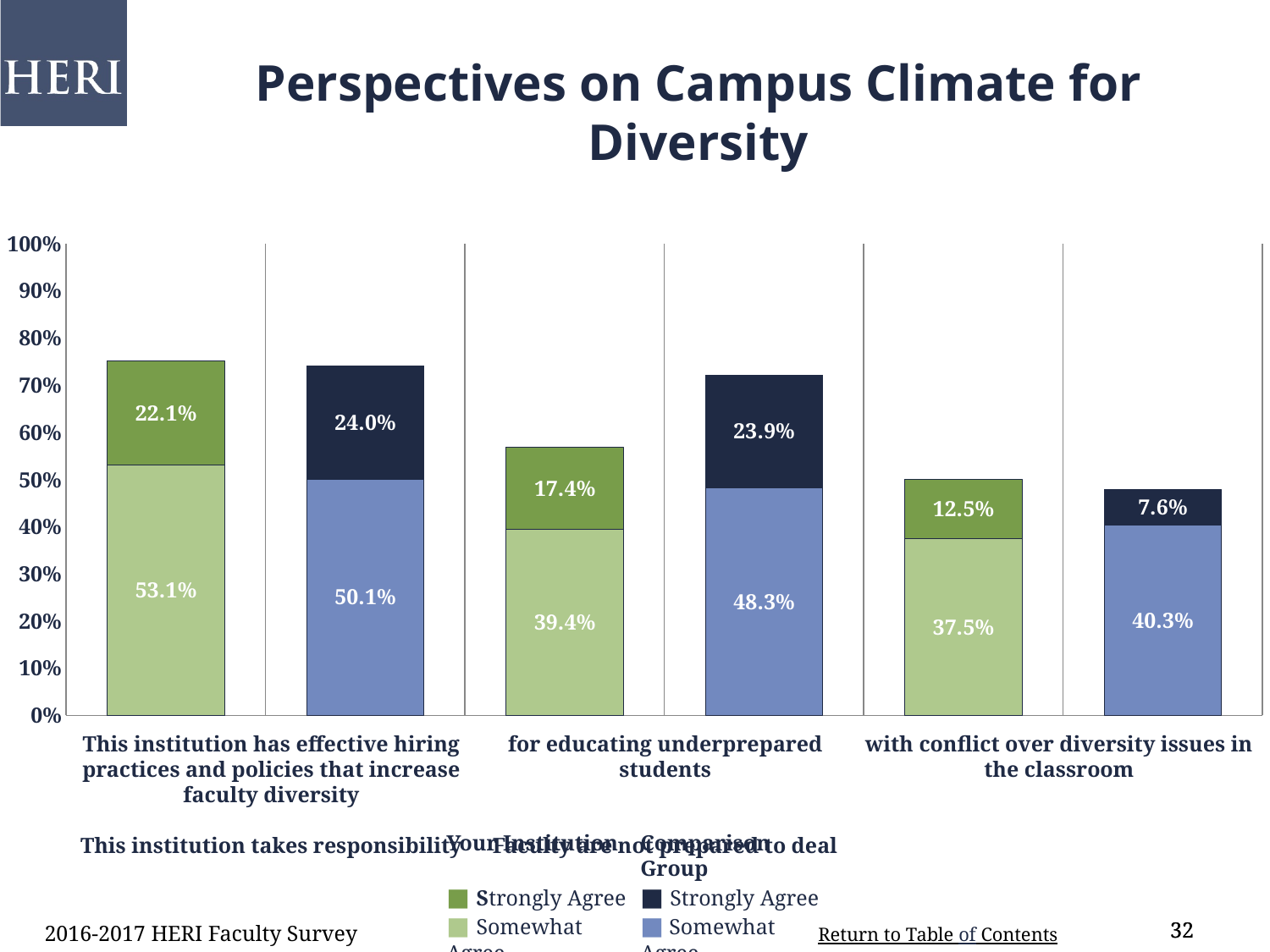
What percentage of the Comparison Group strongly agree that this institution has effective hiring practices and policies that increase faculty diversity? 24.0% What is the total percentage agreeing (strongly plus somewhat) for the Comparison Group on the statement about educating underprepared students? 72.2% What is the total percentage agreeing (strongly plus somewhat) for Your Institution on the statement about effective hiring practices that increase faculty diversity? 75.2% What percentage of the Comparison Group somewhat agree with the statement about educating underprepared students? 48.3% How many entries does the chart legend list? 4 What percentage of Your Institution faculty somewhat agree that this institution has effective hiring practices and policies that increase faculty diversity? 53.1% For the statement about educating underprepared students, which group has the larger 'Somewhat Agree' percentage, Your Institution or the Comparison Group? Comparison Group Which 'Strongly Agree' segment is the smallest on the chart? Comparison Group, conflict over diversity issues in the classroom (7.6%) What percentage of Your Institution faculty strongly agree with the statement about conflict over diversity issues in the classroom? 12.5% What is the chart type used on this slide? stacked bar chart How many statements (categories) are shown on the x axis of the chart? 3 What is the difference between the Comparison Group's and Your Institution's 'Strongly Agree' percentages for the statement about conflict over diversity issues in the classroom? 4.9%